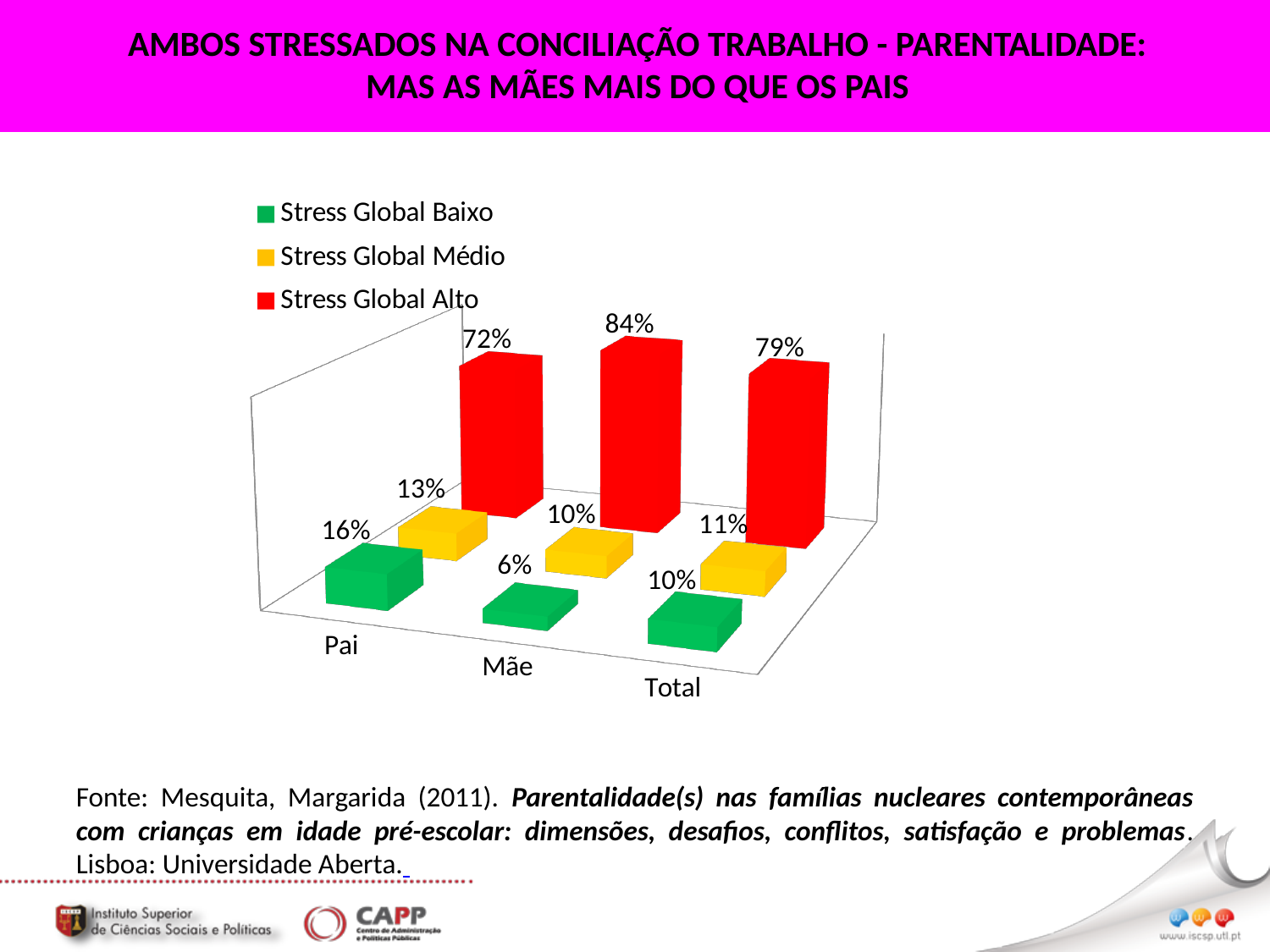
How many series does the legend list? 3 Which category has the highest value for Stress Global Alto? Mãe Which category has the lowest value for Stress Global Baixo? Mãe What kind of chart is shown on the slide? Bar chart Which is larger, Stress Global Médio for Pai or Stress Global Médio for Mãe? Pai What is the value of Stress Global Alto for Pai? 72% What is the difference between the Stress Global Alto values for Mãe and Pai? 12% Which colour represents Stress Global Alto in the legend? Red What is the value of Stress Global Médio for Total? 11% What is the value of Stress Global Baixo for Pai? 16% How many categories are shown on the x axis? 3 What is the value of Stress Global Alto for Mãe? 84%